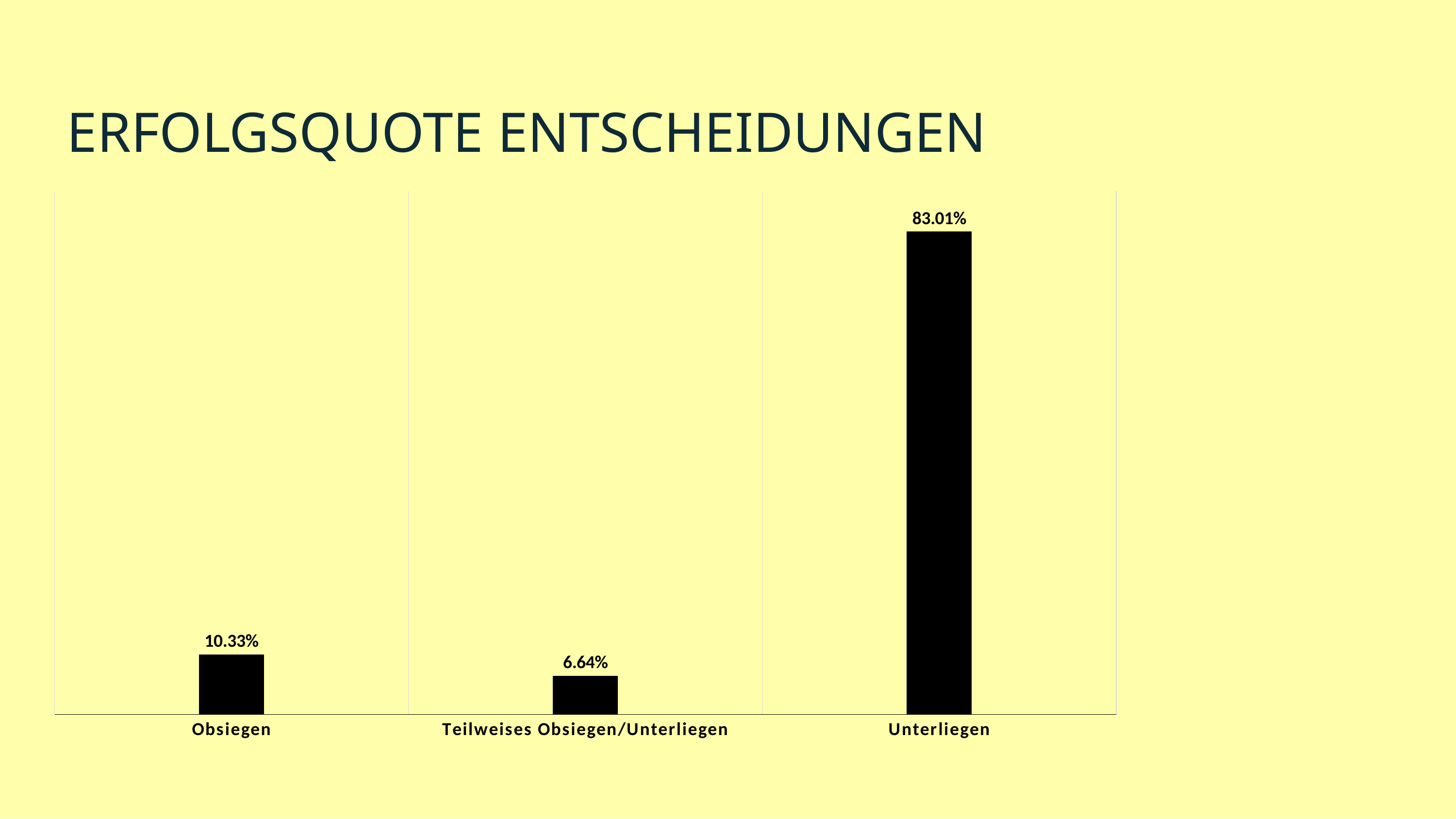
What is the value for Teilweises Obsiegen/Unterliegen? 6.64% Which is larger, the value for Obsiegen or the value for Teilweises Obsiegen/Unterliegen? Obsiegen What kind of chart is shown on the slide? Bar chart What is the difference between the values for Unterliegen and Obsiegen? 72.68% What colour are the bars in the chart? Black What is the value for Unterliegen? 83.01% What is the value for Obsiegen? 10.33% Which category has the highest value? Unterliegen Which category has the lowest value? Teilweises Obsiegen/Unterliegen What is the difference between the values for Obsiegen and Teilweises Obsiegen/Unterliegen? 3.69% How many categories are shown in the chart? 3 What is the title of the slide? ERFOLGSQUOTE ENTSCHEIDUNGEN